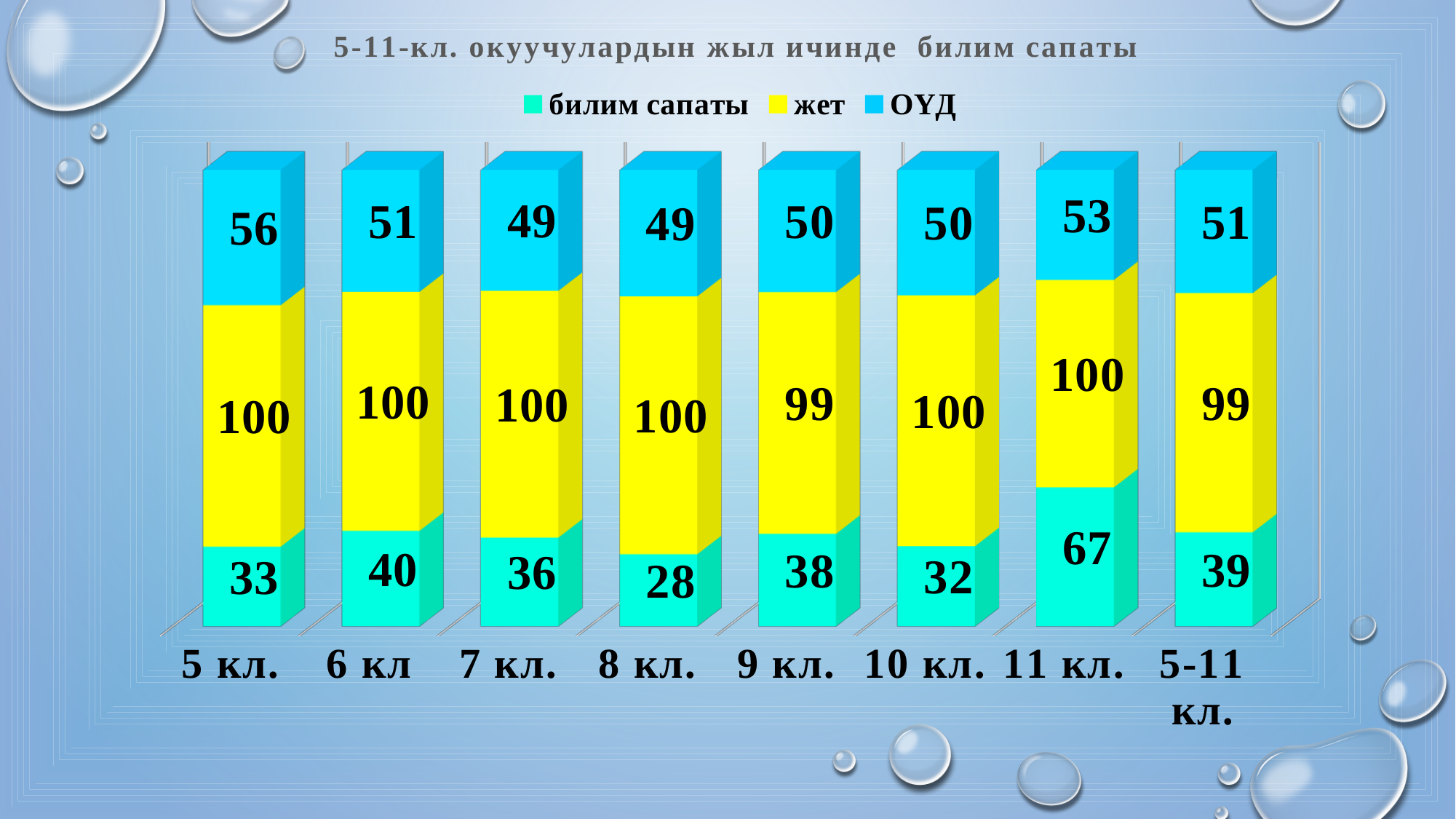
Which is larger, the ОҮД value for 5 кл. or for 11 кл.? 5 кл. What is the difference between the билим сапаты values for 11 кл. and 8 кл.? 39 What is the value of ОҮД for 5 кл.? 56 How many series does the legend list? 3 Which category has the highest билим сапаты value? 11 кл. What kind of chart is shown on the slide? Stacked bar chart What is the value of билим сапаты for 5-11 кл.? 39 How many categories are shown on the x axis? 8 Which category has the lowest билим сапаты value? 8 кл. What is the value of билим сапаты for 11 кл.? 67 What is the value of жет for 9 кл.? 99 What is the total of the stacked bar for 11 кл.? 220